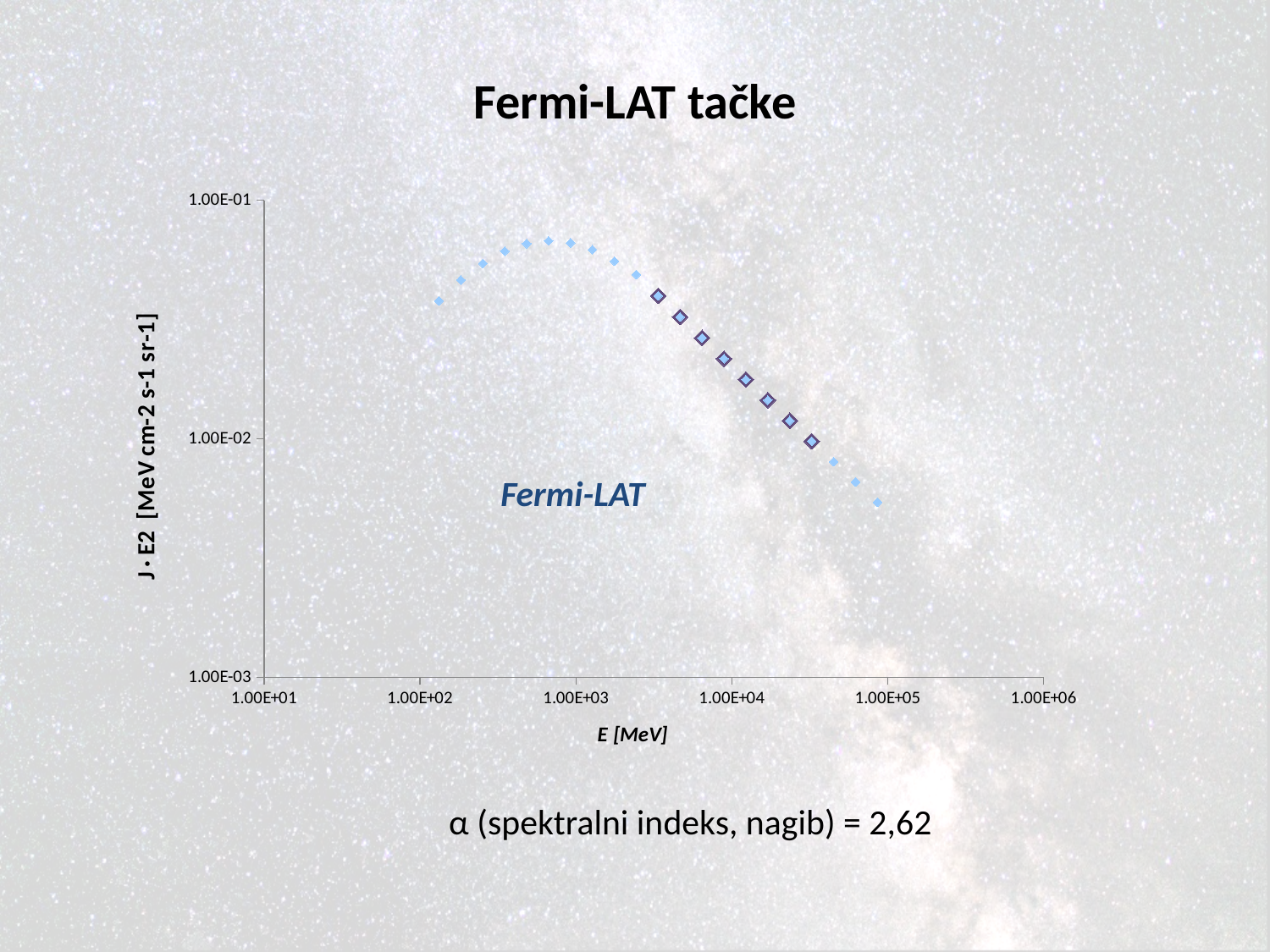
What value of the spectral index α is stated below the chart? 2,62 Do the plotted values rise or fall as E increases beyond 1.00E+03 MeV? fall Is the highest plotted value on the chart greater or less than 1.00E-02? greater Is the highest plotted value on the chart greater or less than 1.00E-01? less Is the value of the first highlighted point (near 3.00E+03 MeV) greater or less than 1.00E-02? greater What kind of chart is shown on the slide? scatter chart How many points are drawn with the dark highlighted diamond marker? 8 What is the label of the x axis of the chart? E [MeV] What is the title of the chart? Fermi-LAT tačke Do the plotted values rise or fall as E increases from 1.00E+02 MeV to about 5.00E+02 MeV? rise